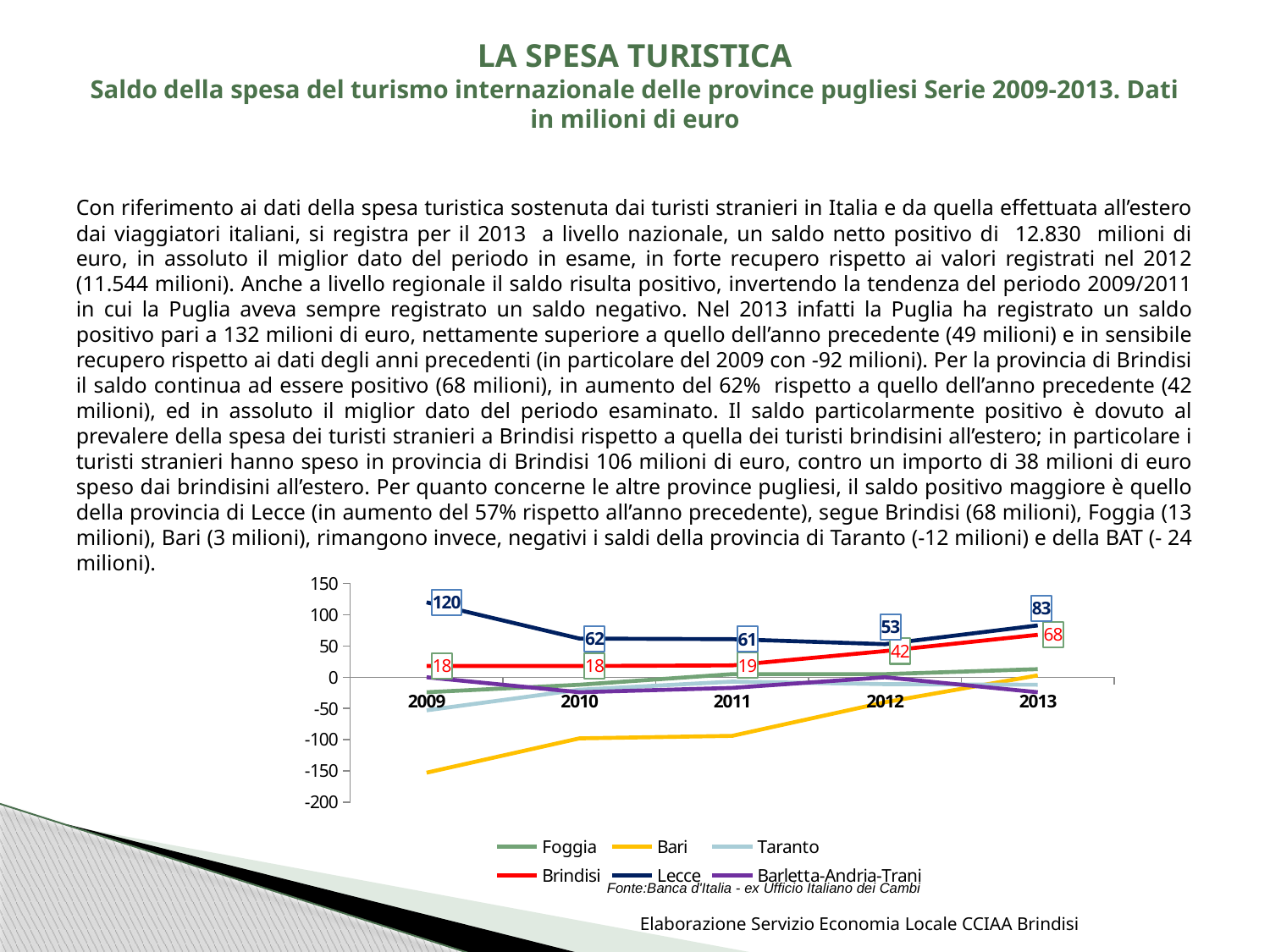
What is the value for Brindisi in 2012? 42 What is the value for Lecce in 2009? 120 By how much did the Brindisi value increase from 2012 to 2013? 26 In which year does the Lecce series reach its lowest value? 2012 Which series has the higher value in 2013, Lecce or Brindisi? Lecce Is the value for Bari in 2009 greater or less than -100? less Does the Brindisi series rise or fall from 2009 to 2013? rise What kind of chart is shown on the slide? line chart In which year does the Lecce series reach its highest value? 2009 How many series does the legend list? 6 What is the value for Brindisi in 2013? 68 How many years are shown on the x axis? 5